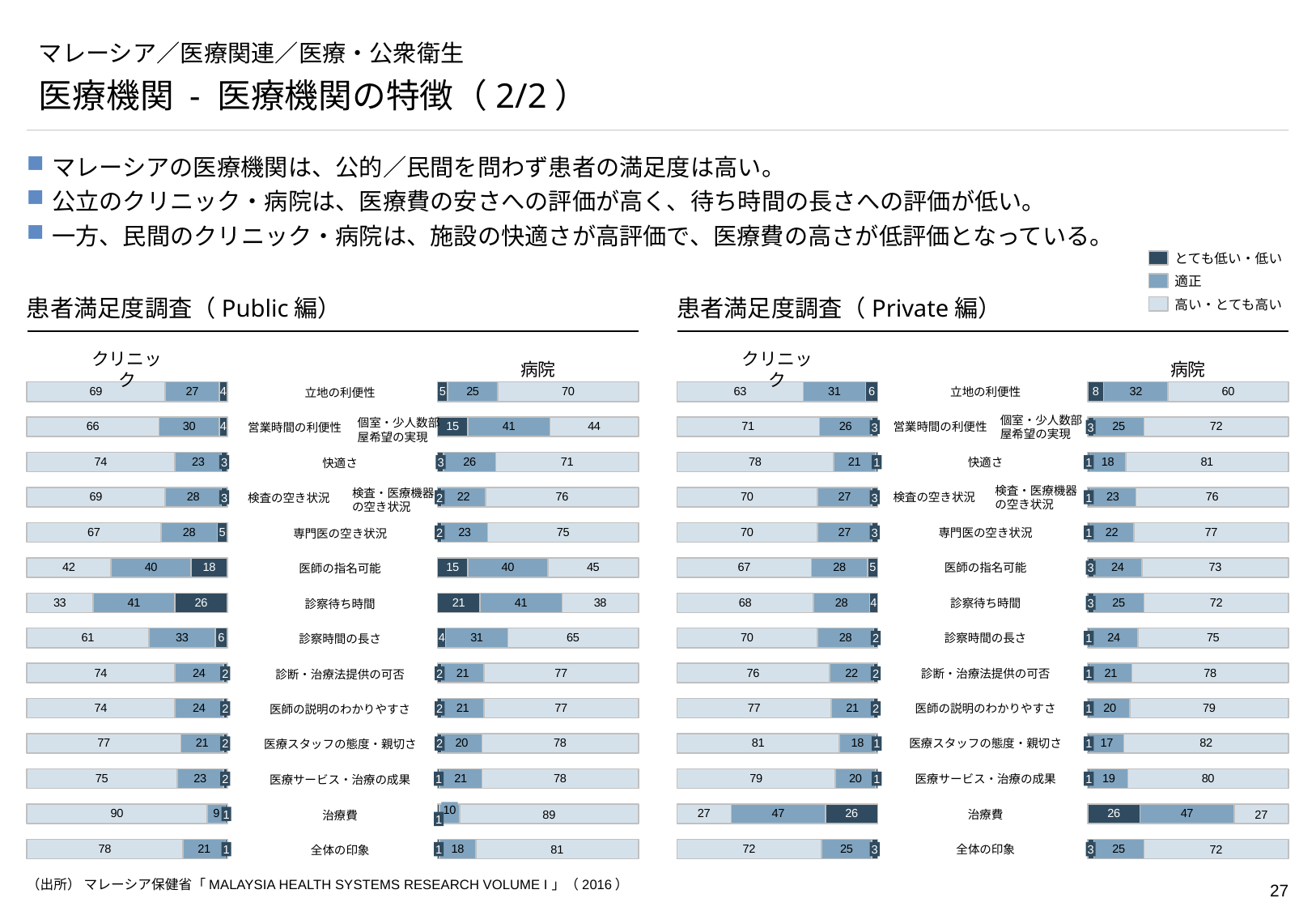
How many series does the legend list? 3 In the 患者満足度調査（Public 編） chart, what is the 高い・とても高い value for 治療費 for クリニック? 90 In the 患者満足度調査（Private 編） chart, which is larger for 病院: the 高い・とても高い value for 快適さ or for 立地の利便性? 快適さ In the 患者満足度調査（Public 編） chart, what is the 適正 value for 個室・少人数部屋希望の実現 for 病院? 41 How many categories are shown in the 患者満足度調査（Public 編） chart? 14 In the 患者満足度調査（Public 編） chart, what is the difference between the 高い・とても高い values for 治療費 and 診察待ち時間 for クリニック? 57 In the 患者満足度調査（Private 編） chart, what is the 適正 value for 治療費 for クリニック? 47 In the 患者満足度調査（Private 編） chart, which クリニック category has the lowest 高い・とても高い value? 治療費 In the 患者満足度調査（Public 編） chart, which クリニック category has the highest とても低い・低い value? 診察待ち時間 What kind of chart is used for the 患者満足度調査 data? Stacked bar chart Which legend entry is shown in the darkest colour? とても低い・低い In the 患者満足度調査（Private 編） chart, what is the とても低い・低い value for 治療費 for 病院? 26